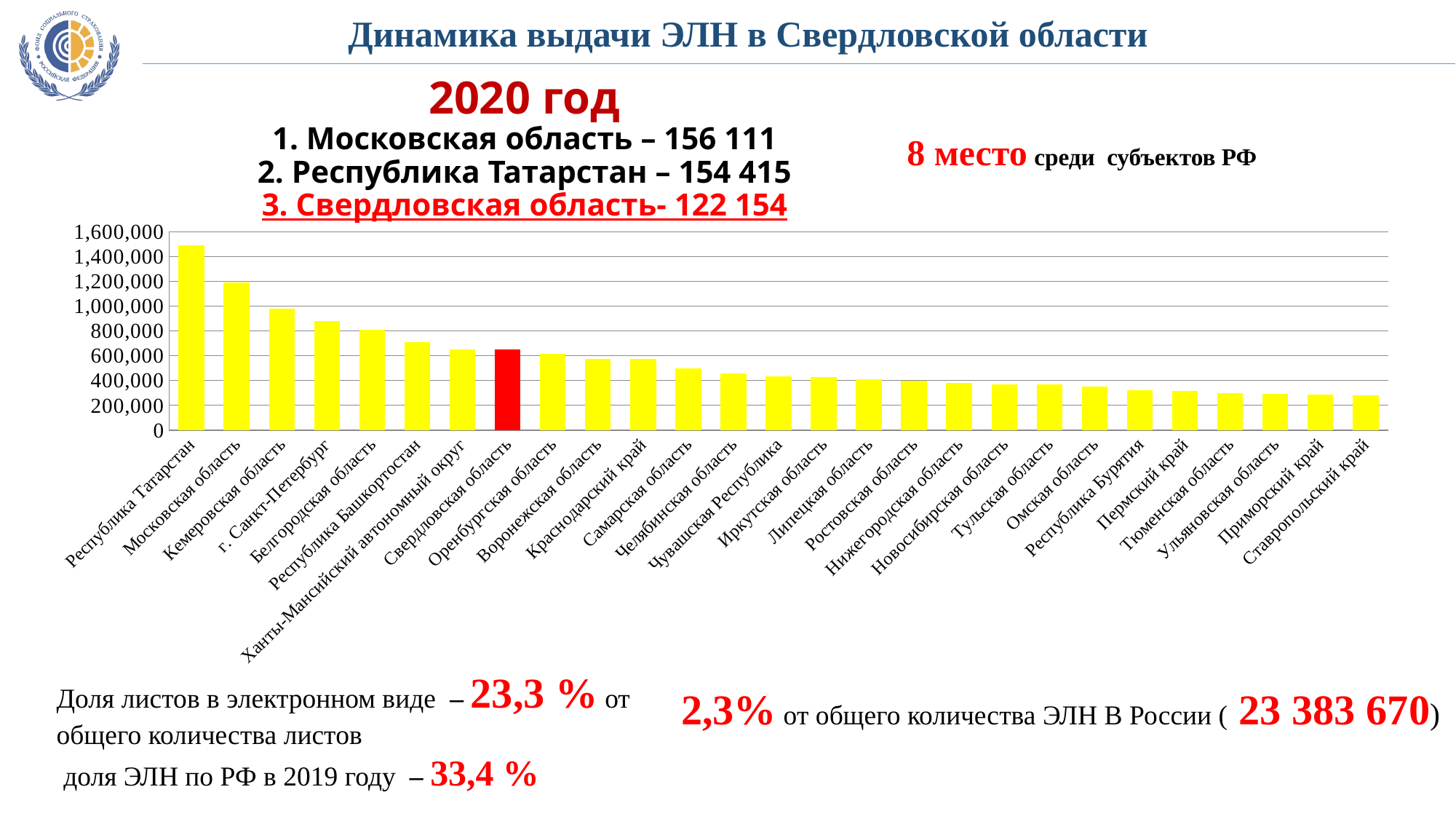
How many regions (categories) are plotted in the bar chart? 27 Which region has the highest bar in the chart? Республика Татарстан Is the value for Ставропольский край greater or less than 400,000? less What kind of chart is shown on the slide? bar chart Which has a larger value, Самарская область or Челябинская область? Самарская область Is the value for Республика Татарстан greater or less than 1,400,000? greater Is the value for Свердловская область greater or less than 800,000? less Which has a larger value, Кемеровская область or Белгородская область? Кемеровская область Do the bar values rise or fall from left to right along the x axis? fall Which region has the lowest bar in the chart? Ставропольский край Which region's bar is coloured red instead of yellow? Свердловская область